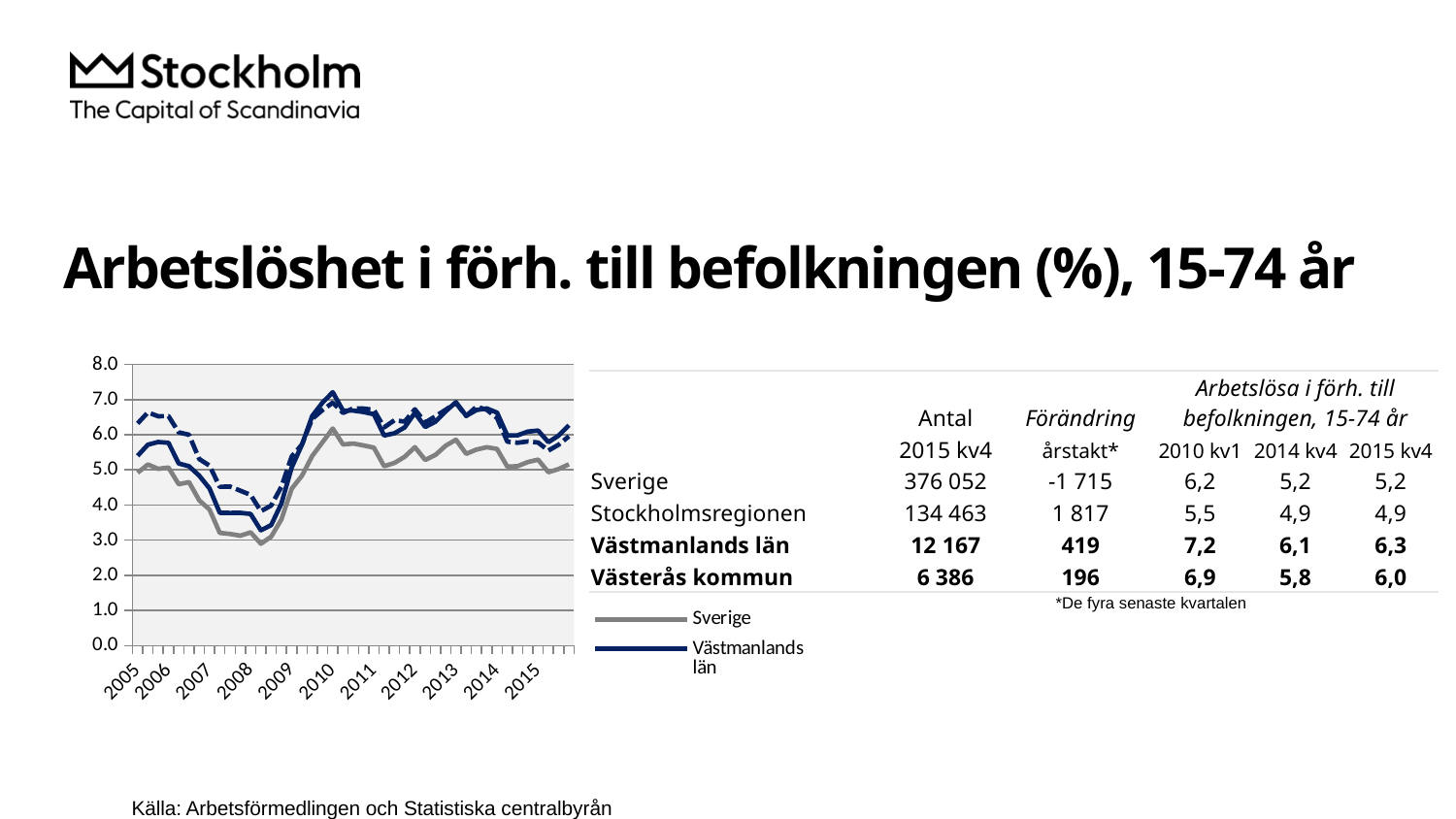
What is the highest value shown on the chart's y axis? 8.0 How many year labels are shown on the chart's x axis? 11 Do the values for Västmanlands län rise or fall between 2005 and 2008? fall Is the value for Sverige at the end of 2015 greater or less than 6.0? less Is the lowest value for Västmanlands län around 2008 greater or less than 4.0? less Which line is higher in 2013, Sverige or Västmanlands län? Västmanlands län How many series does the chart's legend list? 2 What kind of chart is shown on the slide? line chart Is the peak value for Västmanlands län around 2010 greater or less than 7.0? greater Which two series are named in the chart's legend? Sverige and Västmanlands län Do the values for Sverige rise or fall between 2008 and 2010? rise